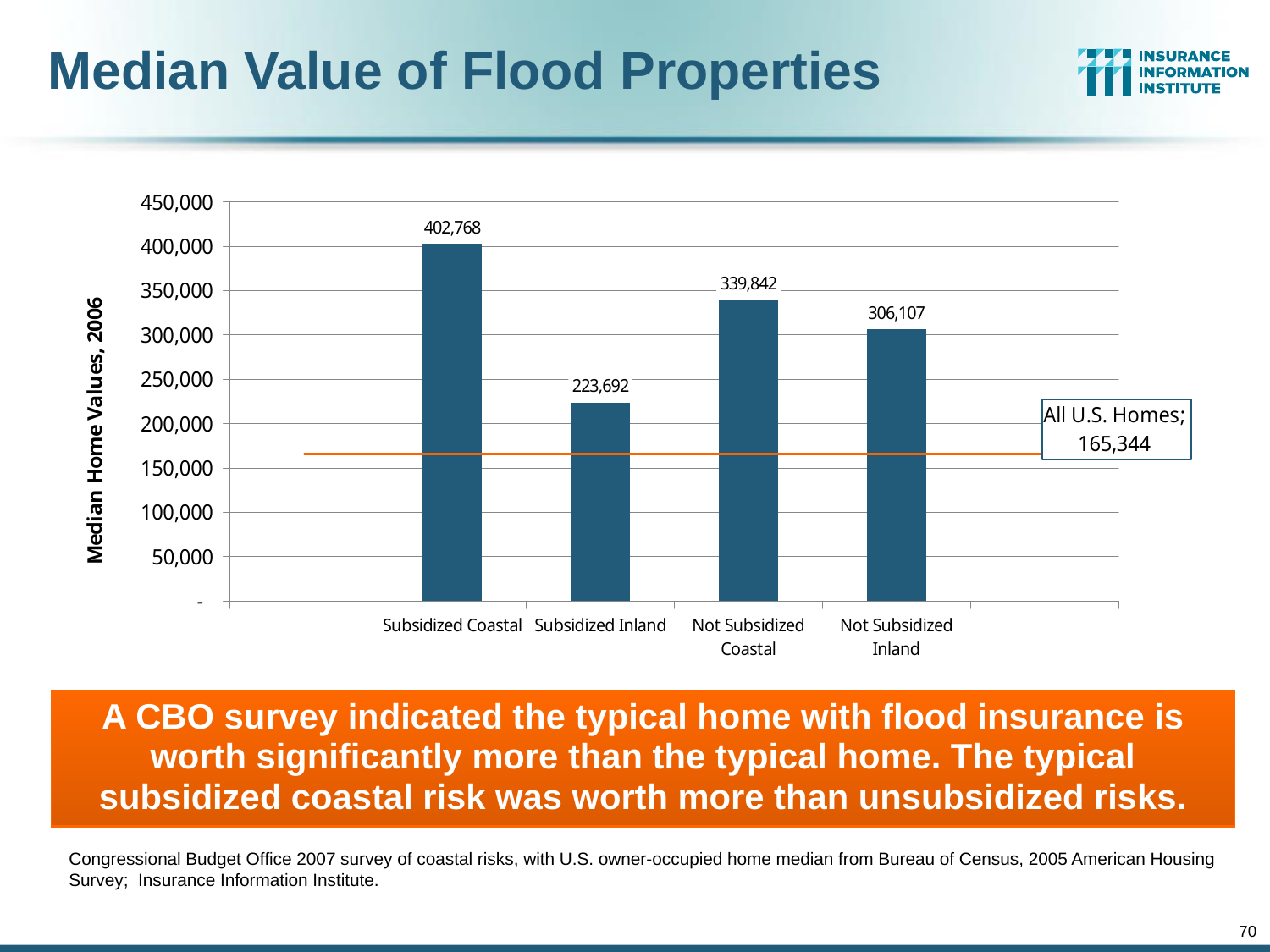
What is the median home value for Not Subsidized Inland properties? 306,107 How many property categories are shown as bars in the chart? 4 What is the median value for All U.S. Homes shown by the horizontal line? 165,344 Which category has the lowest median home value? Subsidized Inland What is the difference between the median home values of Subsidized Coastal and Not Subsidized Coastal properties? 62,926 What is the label of the vertical axis? Median Home Values, 2006 Which category has the highest median home value? Subsidized Coastal What is the median home value for Subsidized Inland properties? 223,692 Which is larger, the median home value for Not Subsidized Coastal or Not Subsidized Inland? Not Subsidized Coastal What is the median home value for Not Subsidized Coastal properties? 339,842 What is the median home value for Subsidized Coastal properties? 402,768 What kind of chart is shown on the slide? Bar chart